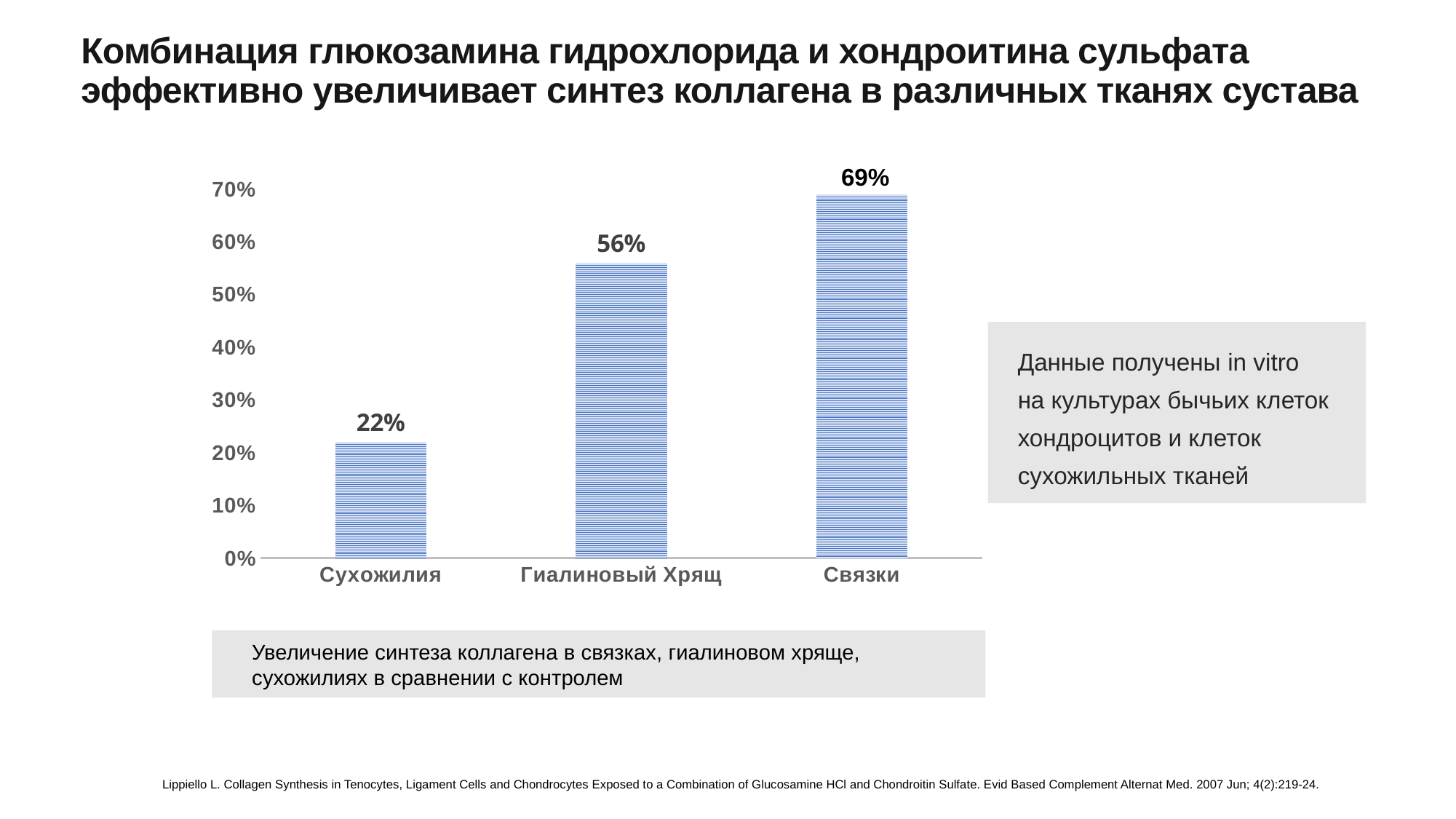
Is the value for Гиалиновый Хрящ greater or less than 50%? greater Which category has the highest value? Связки Which category has the lowest value? Сухожилия What is the difference between the values for Гиалиновый Хрящ and Сухожилия? 34% Which is larger, the value for Гиалиновый Хрящ or the value for Связки? Связки Do the values rise or fall from left to right along the x axis? rise What kind of chart is shown on the slide? bar chart What is the value for Сухожилия? 22% What is the value for Гиалиновый Хрящ? 56% What is the value for Связки? 69% How many categories are shown on the chart? 3 What is the difference between the values for Связки and Сухожилия? 47%